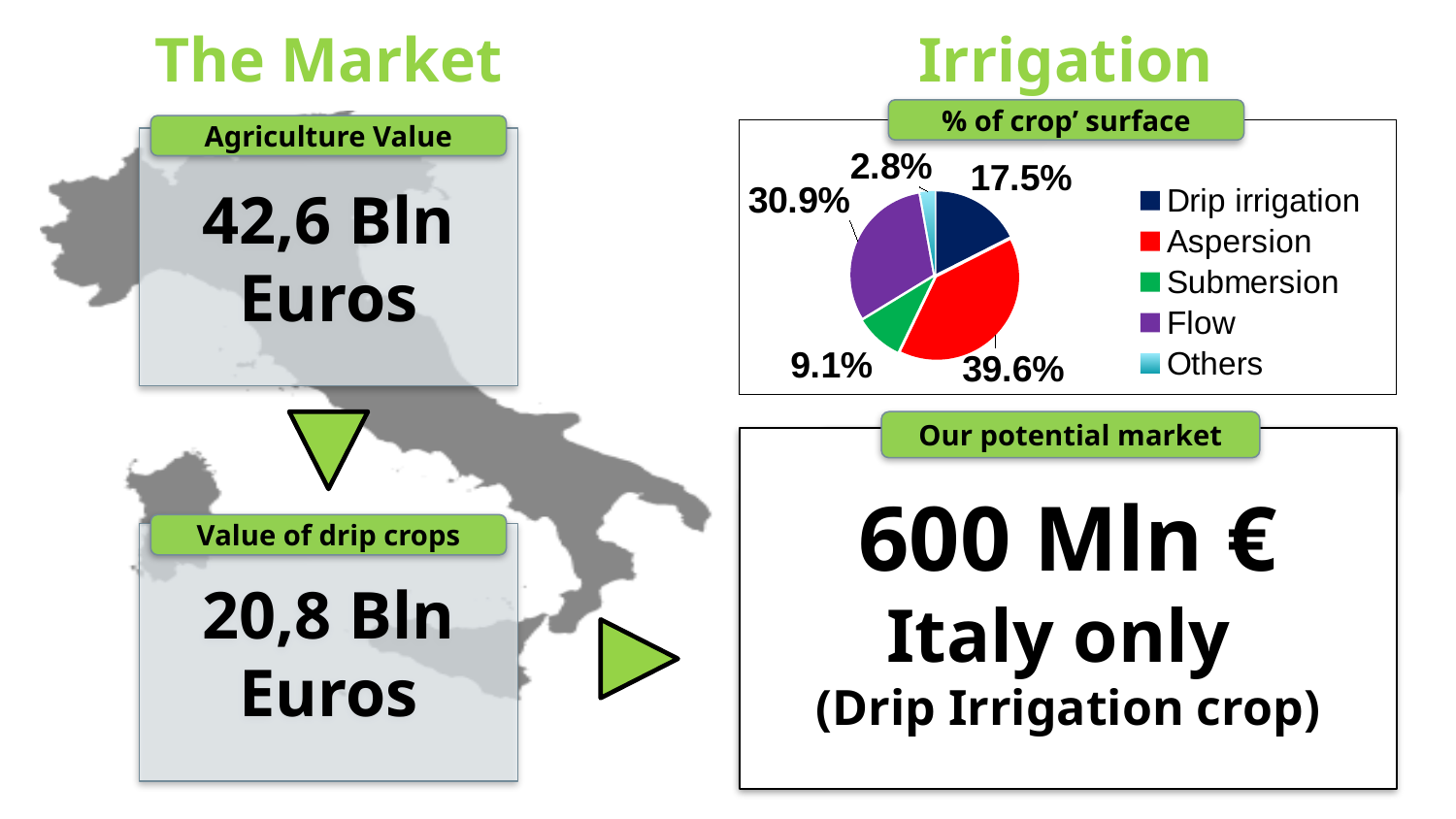
Which irrigation method has the smallest share of crop surface in the pie chart? Others What share of crop surface is shown for Flow irrigation? 30.9% What percentage is shown for Others in the pie chart? 2.8% How many slices does the pie chart have? 5 What percentage of crop surface is irrigated by drip irrigation? 17.5% What percentage of crop surface does Aspersion account for in the pie chart? 39.6% How many percentage points larger is the Aspersion share than the Drip irrigation share? 22.1 Which has a larger share of crop surface, Flow or Submersion? Flow What percentage is shown for Submersion in the pie chart? 9.1% What colour represents Drip irrigation in the pie chart legend? Dark blue What kind of chart is shown under the heading "% of crop' surface"? Pie chart Which irrigation method has the largest share of crop surface in the pie chart? Aspersion